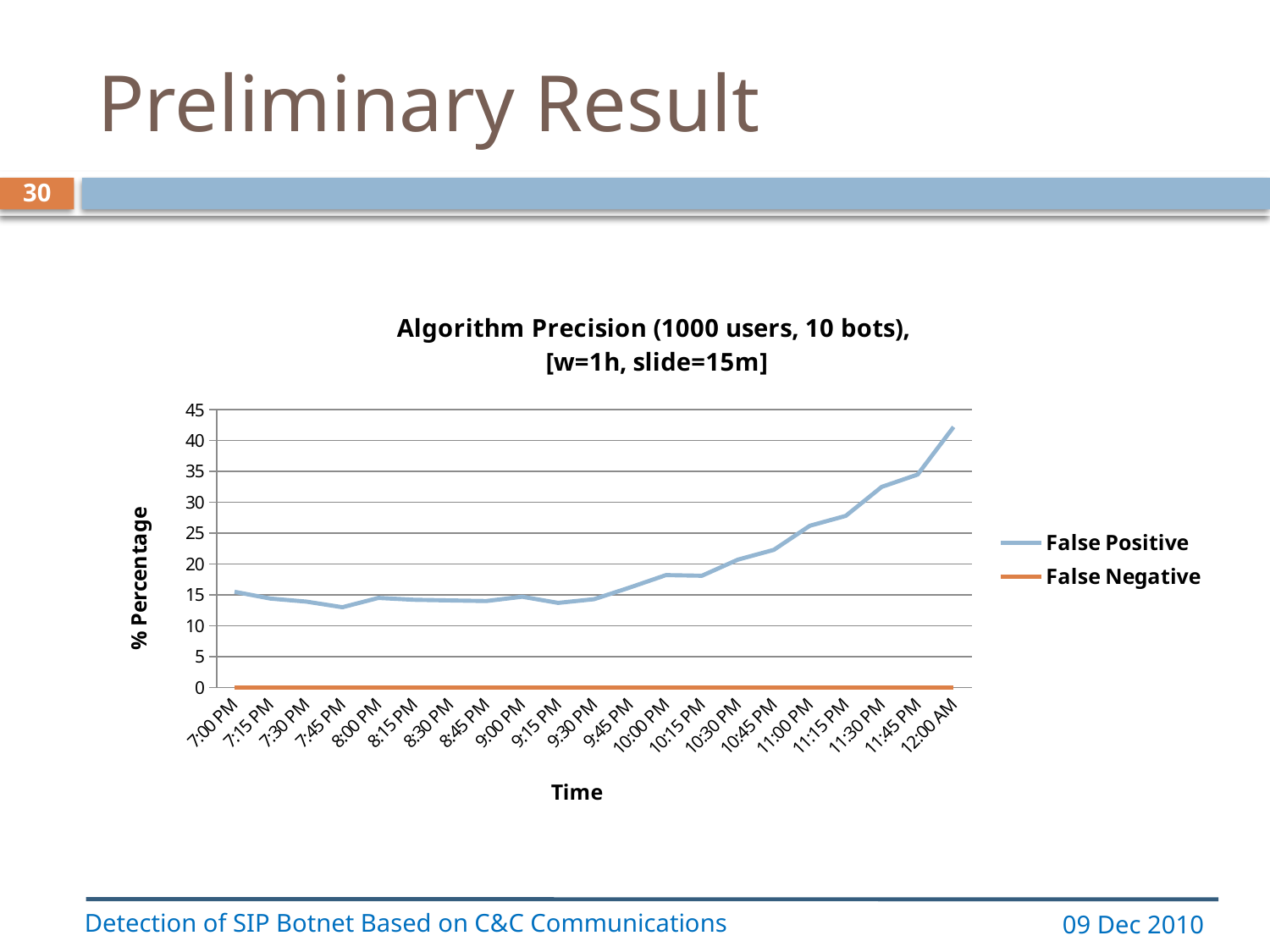
How many series does the legend list? 2 Does the False Positive line generally rise or fall from 9:30 PM to 12:00 AM? rise Is the False Positive value at 7:45 PM greater or less than 15? less Is the False Positive value at 10:00 PM greater or less than 20? less What is the False Negative value at 9:00 PM? 0 How many time points are plotted along the x axis? 21 Is the False Positive value at 11:30 PM greater or less than 30? greater What are the two series named in the legend? False Positive and False Negative At which time is the False Positive value highest? 12:00 AM Which series has the larger value at 11:00 PM, False Positive or False Negative? False Positive What kind of chart is shown on the slide? line chart